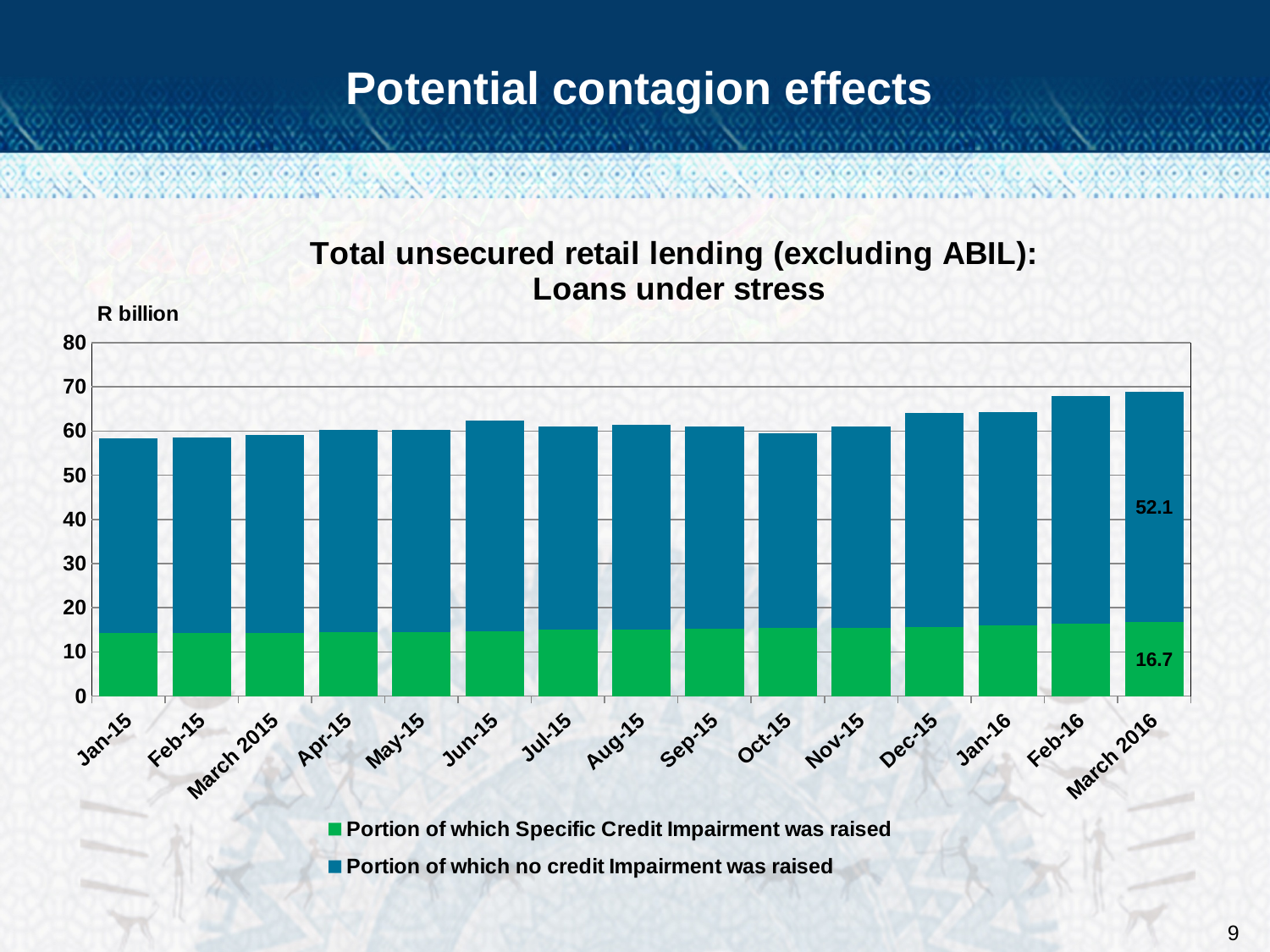
What is the total height of the stacked bar for March 2016? 68.8 In March 2016, what is the difference between the portion with no credit impairment raised and the portion with specific credit impairment raised? 35.4 Is the total value of the stacked bar for Jan-15 greater or less than 50? greater How many series does the chart legend list? 2 Do the total loans under stress rise or fall from Jan-15 to March 2016? Rise How many months are shown on the x axis of the chart? 15 Is the total value of the stacked bar for Oct-15 greater or less than 70? less What kind of chart is shown on the slide? Stacked bar chart What is the value of the 'Portion of which no credit Impairment was raised' for March 2016? 52.1 What is the value of the 'Portion of which Specific Credit Impairment was raised' for March 2016? 16.7 What unit is shown on the y axis of the chart? R billion In March 2016, which portion is larger: the portion with specific credit impairment raised or the portion with no credit impairment raised? Portion of which no credit Impairment was raised